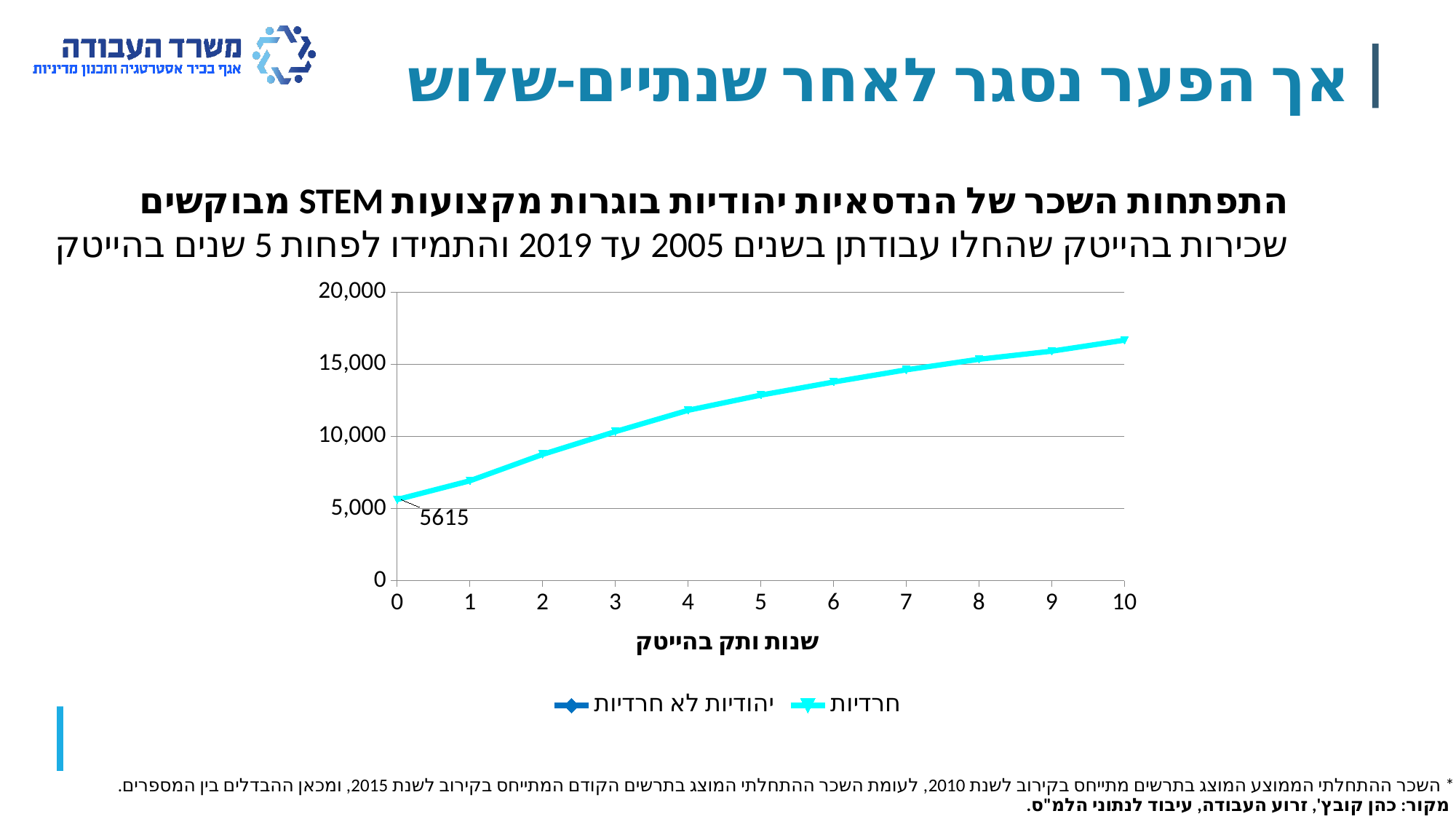
How many data points are plotted along the x axis for the חרדיות series? 11 Do the values of the חרדיות series rise or fall as years of seniority increase along the x axis? rise Is the value for the חרדיות series at 5 years of seniority greater or less than 10,000? greater Is the value for the חרדיות series at 10 years of seniority greater or less than 15,000? greater At which x-axis value (years of seniority) is the חרדיות series highest? 10 Which is larger for the חרדיות series: the value at 10 years of seniority or the value at 0 years? 10 years How many series does the legend list? 2 At which x-axis value (years of seniority) is the חרדיות series lowest? 0 Is the value for the חרדיות series at 2 years of seniority greater or less than 10,000? less What is the labelled wage value for the חרדיות series at 0 years of seniority (x = 0)? 5615 What is the title of the x axis of the chart? שנות ותק בהייטק What kind of chart is shown on the slide? line chart